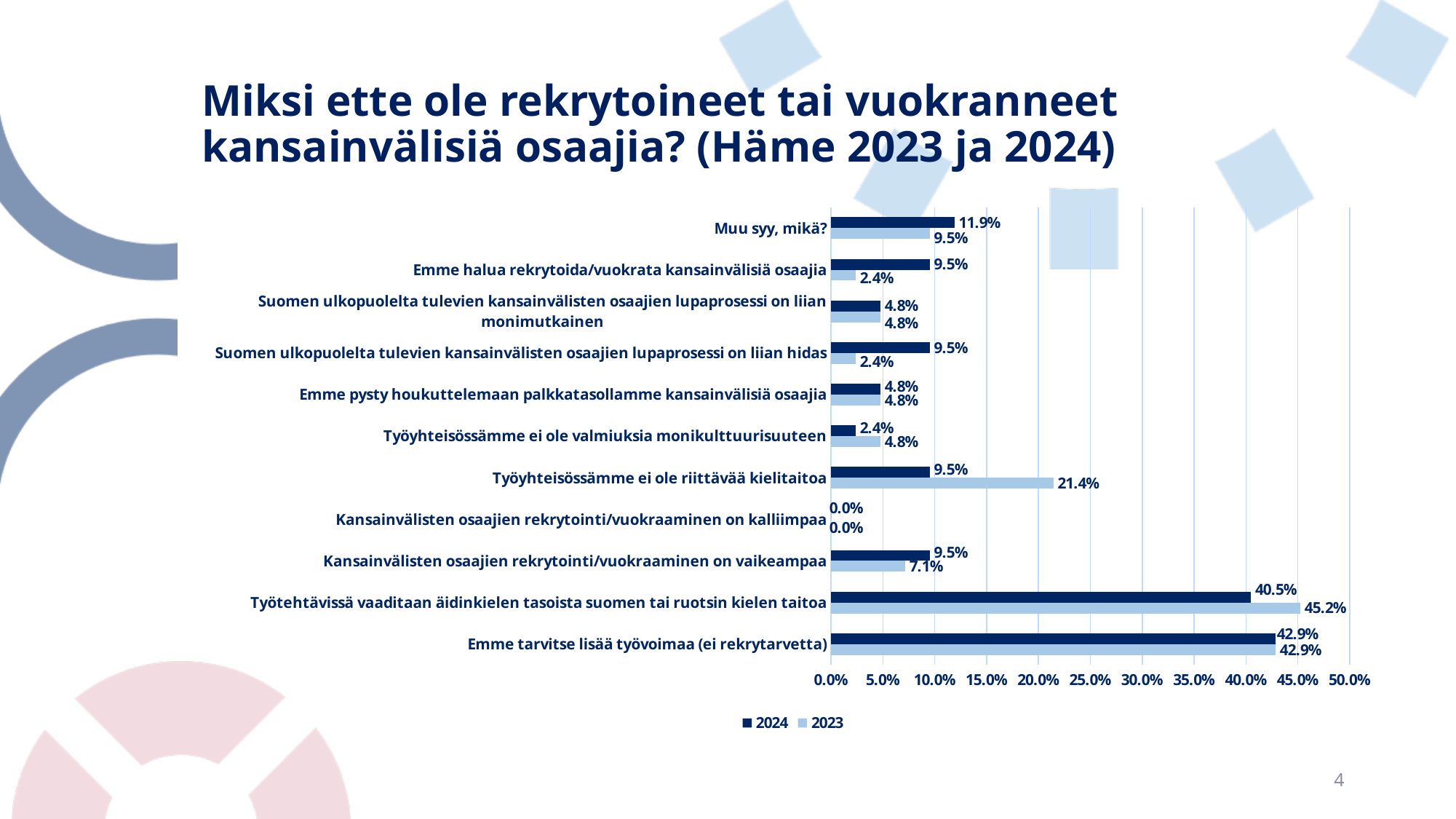
What is the 2024 value for "Muu syy, mikä?"? 11.9% What is the 2023 value for "Työtehtävissä vaaditaan äidinkielen tasoista suomen tai ruotsin kielen taitoa"? 45.2% Which category has the highest 2024 value? Emme tarvitse lisää työvoimaa (ei rekrytarvetta) How many series does the legend list? 2 What is the difference between the 2023 and 2024 values for "Työyhteisössämme ei ole riittävää kielitaitoa"? 11.9% What kind of chart is shown on the slide? Bar chart What is the 2023 value for "Työyhteisössämme ei ole riittävää kielitaitoa"? 21.4% What is the difference between the 2023 and 2024 values for "Työtehtävissä vaaditaan äidinkielen tasoista suomen tai ruotsin kielen taitoa"? 4.7% For "Emme halua rekrytoida/vuokrata kansainvälisiä osaajia", which year has the larger value, 2024 or 2023? 2024 Which category has the lowest 2024 value? Kansainvälisten osaajien rekrytointi/vuokraaminen on kalliimpaa How many categories are shown on the chart? 11 Which category has the highest 2023 value? Työtehtävissä vaaditaan äidinkielen tasoista suomen tai ruotsin kielen taitoa